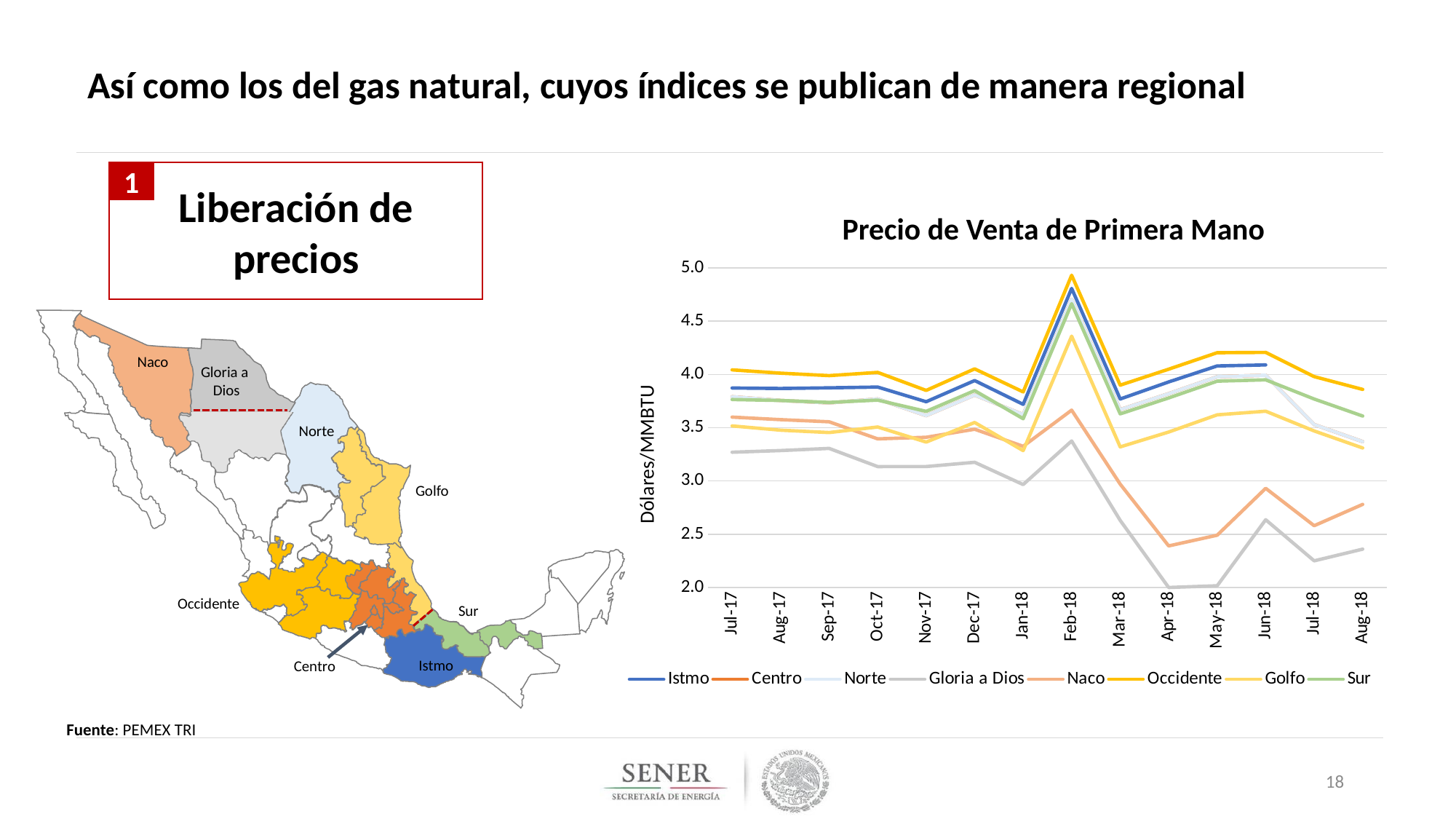
In the "Precio de Venta de Primera Mano" chart, is the Gloria a Dios value in Apr-18 greater or less than 2.5? less What is the y-axis label of the "Precio de Venta de Primera Mano" chart? Dólares/MMBTU How many series does the legend of the "Precio de Venta de Primera Mano" chart list? 8 In the "Precio de Venta de Primera Mano" chart, is the Istmo value in Jul-17 greater or less than 3.5? greater How many months are shown on the x axis of the "Precio de Venta de Primera Mano" chart? 14 In the "Precio de Venta de Primera Mano" chart, which is larger in Feb-18: Occidente or Naco? Occidente In the "Precio de Venta de Primera Mano" chart, which series reaches the highest value in Feb-18? Occidente In the "Precio de Venta de Primera Mano" chart, which series has the lowest value in Apr-18? Gloria a Dios What kind of chart is "Precio de Venta de Primera Mano"? Line chart In the "Precio de Venta de Primera Mano" chart, does the Gloria a Dios series rise or fall overall from Jul-17 to Aug-18? Fall In the "Precio de Venta de Primera Mano" chart, in which month does the Occidente series reach its highest value? Feb-18 In the "Precio de Venta de Primera Mano" chart, is the Occidente value in Feb-18 greater or less than 4.5? greater